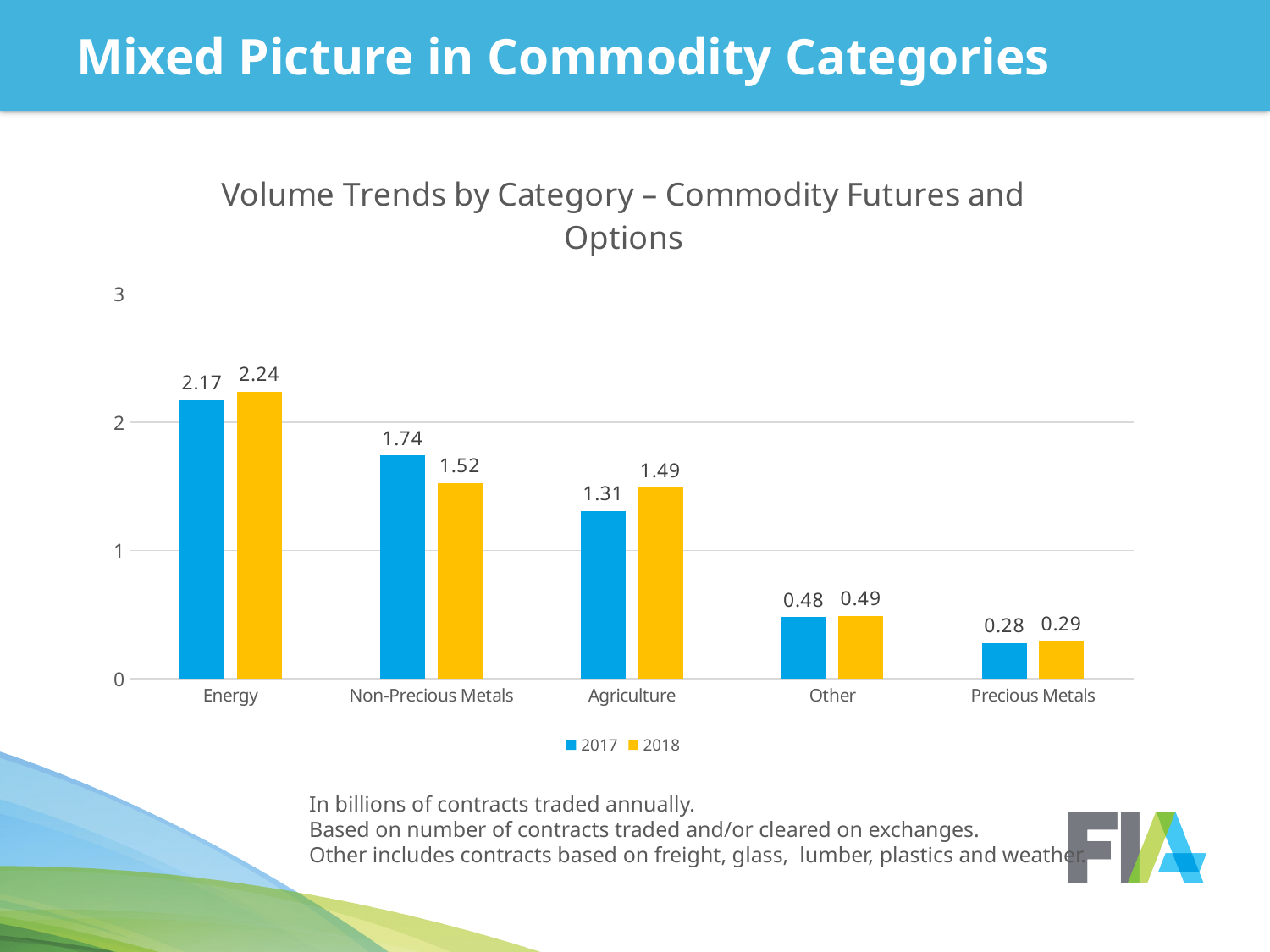
For Agriculture, which year has the larger value, 2017 or 2018? 2018 What is the 2018 value for Energy? 2.24 Is the 2017 value for Energy greater or less than 2? greater Which category has the highest 2017 value? Energy What is the 2017 value for Non-Precious Metals? 1.74 How many categories are shown on the x axis? 5 What is the 2018 value for Agriculture? 1.49 Which category has the lowest 2018 value? Precious Metals What is the difference between the 2017 and 2018 values for Non-Precious Metals? 0.22 What is the title of the chart? Volume Trends by Category – Commodity Futures and Options How many series does the legend list? 2 What kind of chart is shown on the slide? Bar chart